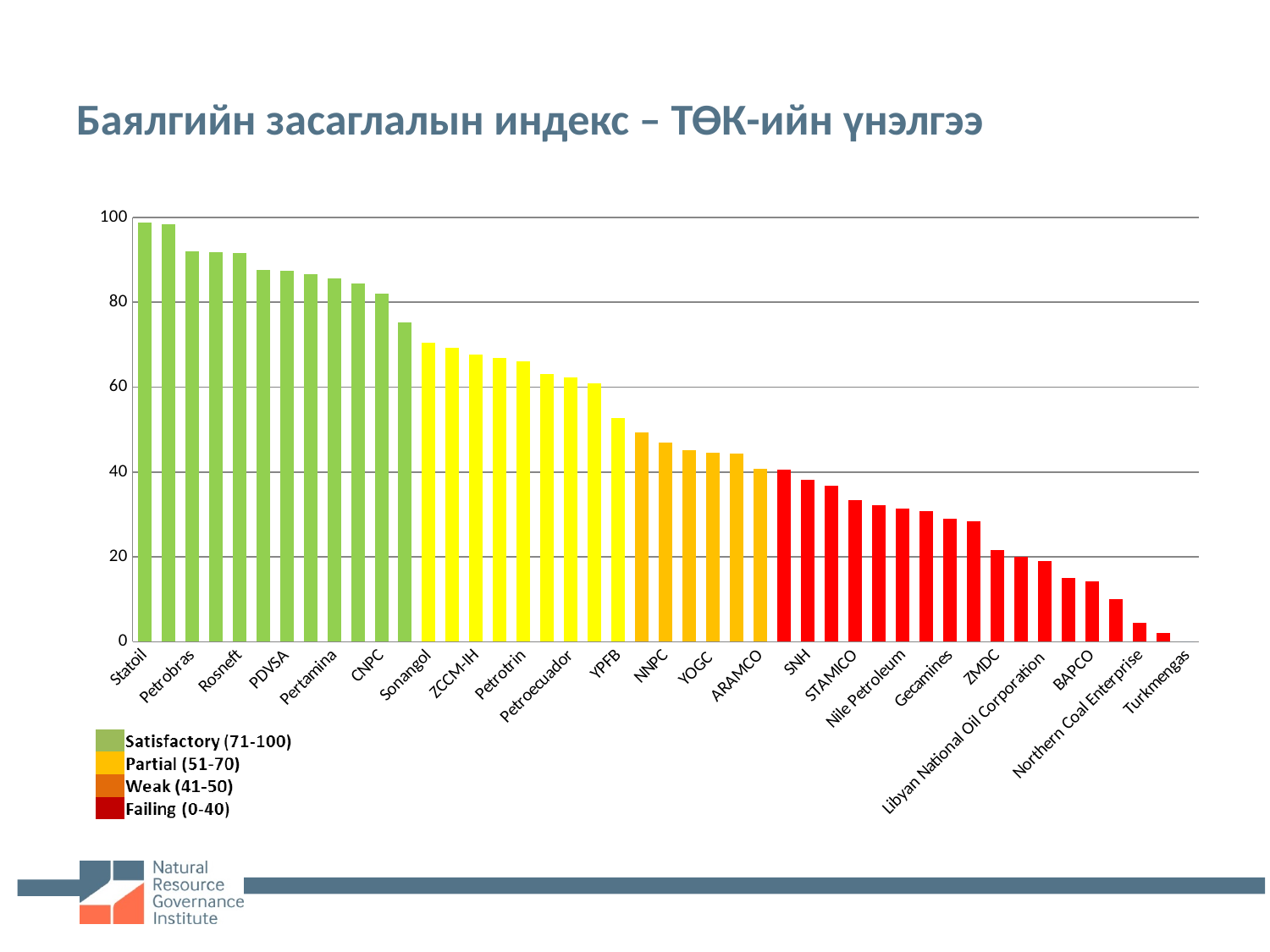
Is the value for BAPCO greater or less than 20? less What score range does the legend give for the 'Partial' category? 51-70 Is the value for Gecamines greater or less than 40? less What kind of chart is shown on the slide? bar chart Is the value for YPFB greater or less than 80? less Which is larger, the value for Statoil or the value for Turkmengas? Statoil Do the values rise or fall moving from left to right along the x axis? fall Which company has the lowest value on the chart? Turkmengas